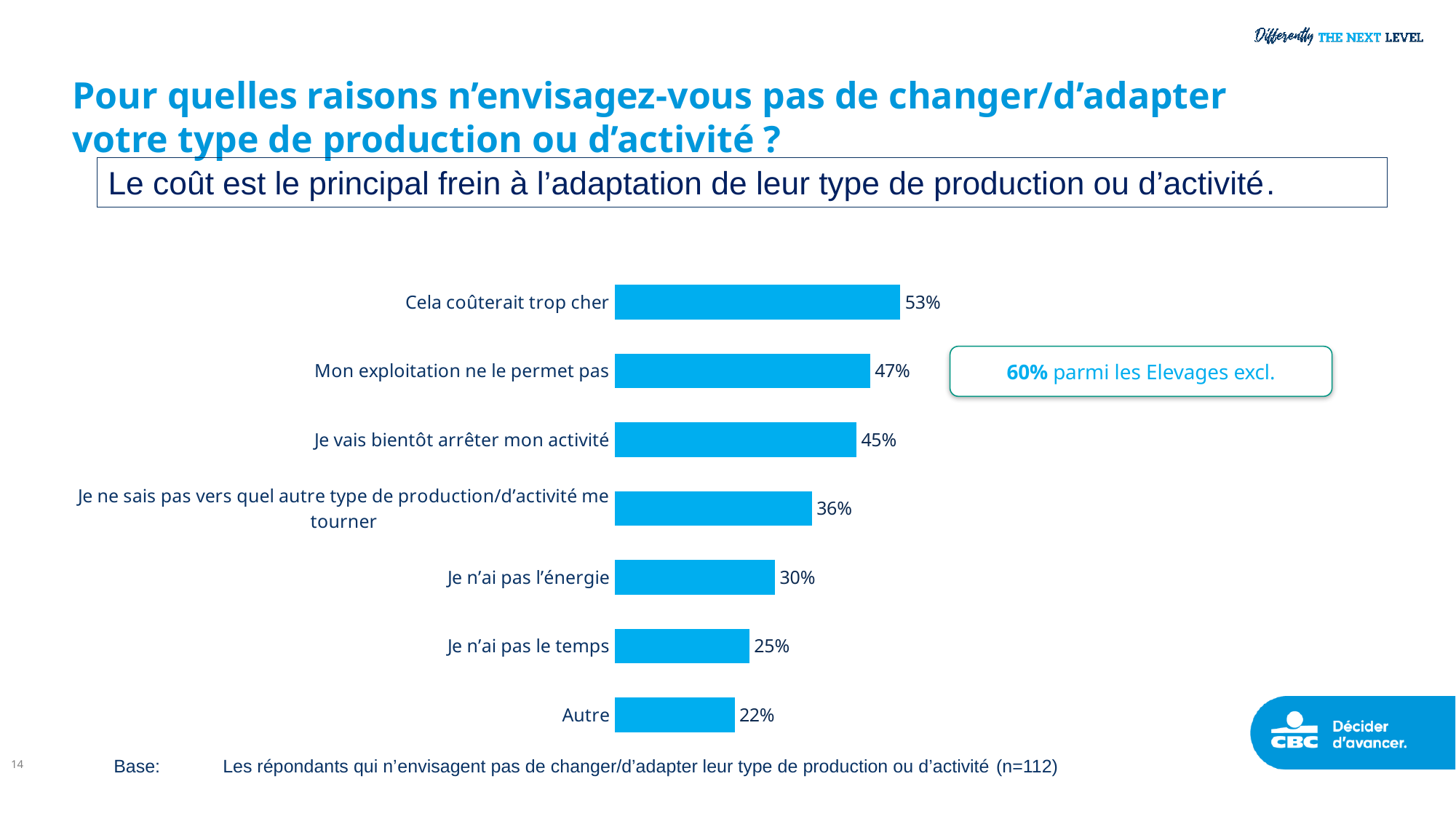
What is the value for "Cela coûterait trop cher"? 53% According to the callout box, what is the value for "Mon exploitation ne le permet pas" among "Elevages excl."? 60% What is the difference between "Je n'ai pas l'énergie" and "Autre"? 8 percentage points What is the value for "Je vais bientôt arrêter mon activité"? 45% Which category has the lowest value? Autre Which category has the highest value? Cela coûterait trop cher How many categories are shown in the chart? 7 What is the value for "Autre"? 22% What is the difference between "Cela coûterait trop cher" and "Mon exploitation ne le permet pas"? 6 percentage points What kind of chart is shown on the slide? Bar chart Which is larger: "Je ne sais pas vers quel autre type de production/d'activité me tourner" or "Je n'ai pas l'énergie"? Je ne sais pas vers quel autre type de production/d'activité me tourner What is the value for "Je n'ai pas le temps"? 25%